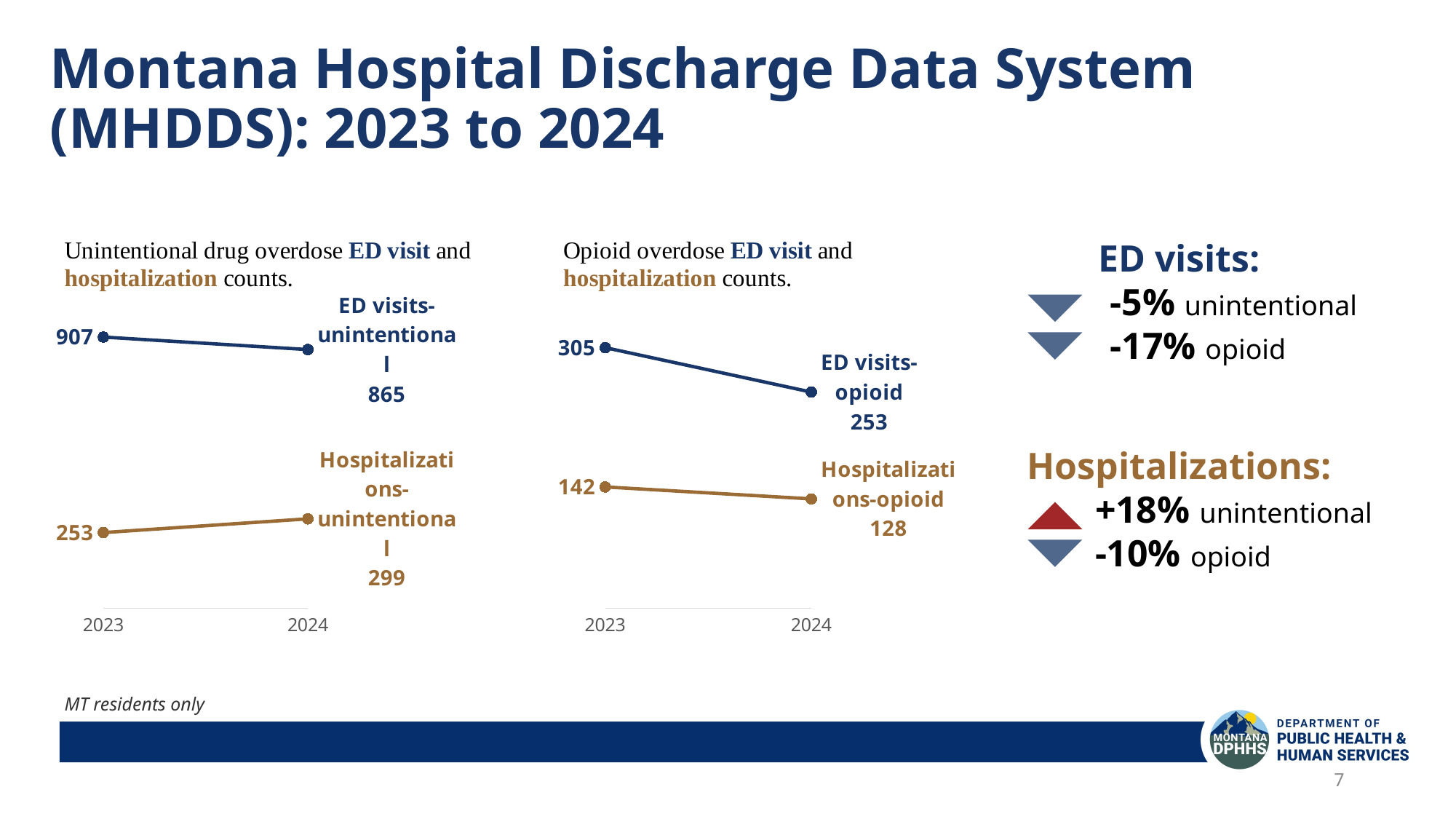
In the unintentional drug overdose chart (left), what was the hospitalizations count in 2024? 299 In the opioid overdose chart (right), which was larger in 2024: ED visits or hospitalizations? ED visits What type of chart is used for the unintentional drug overdose counts (left)? line chart In the unintentional drug overdose chart (left), what was the ED visits count in 2023? 907 How many series are plotted in the unintentional drug overdose chart (left)? 2 In the opioid overdose chart (right), what was the hospitalizations count in 2023? 142 In the unintentional drug overdose chart (left), did hospitalizations rise or fall from 2023 to 2024? rise In the unintentional drug overdose chart (left), by how much did ED visits change from 2023 to 2024? 42 In the opioid overdose chart (right), did ED visits rise or fall from 2023 to 2024? fall How many years are plotted on the x axis of the opioid overdose chart (right)? 2 In the opioid overdose chart (right), what is the difference between ED visits in 2023 and 2024? 52 In the opioid overdose chart (right), what was the ED visits count in 2024? 253